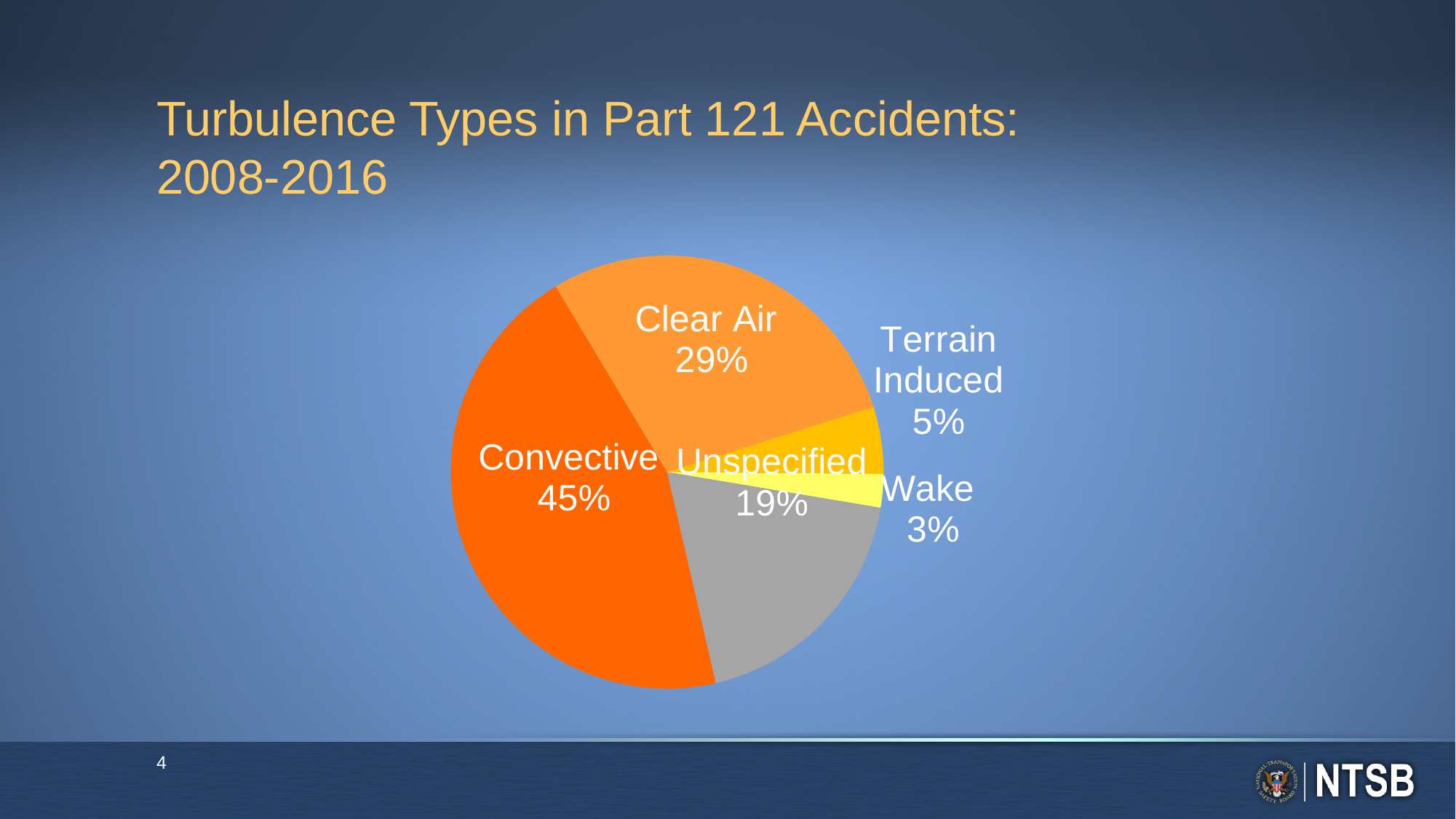
What percentage is shown for Wake turbulence? 3% What is the title of the slide containing the pie chart? Turbulence Types in Part 121 Accidents: 2008-2016 Which turbulence type has the smallest share of the pie? Wake How many slices does the pie chart have? 5 What type of chart is shown on the slide? pie chart What percentage is shown for Terrain Induced turbulence? 5% What is the value shown for the Unspecified slice? 19% What percentage of the pie is labelled Clear Air? 29% Which turbulence type has the largest share of the pie? Convective What is the difference in percentage points between Convective and Clear Air? 16 Which is larger, the Unspecified slice or the Clear Air slice? Clear Air What share of Part 121 turbulence accidents is attributed to Convective turbulence? 45%